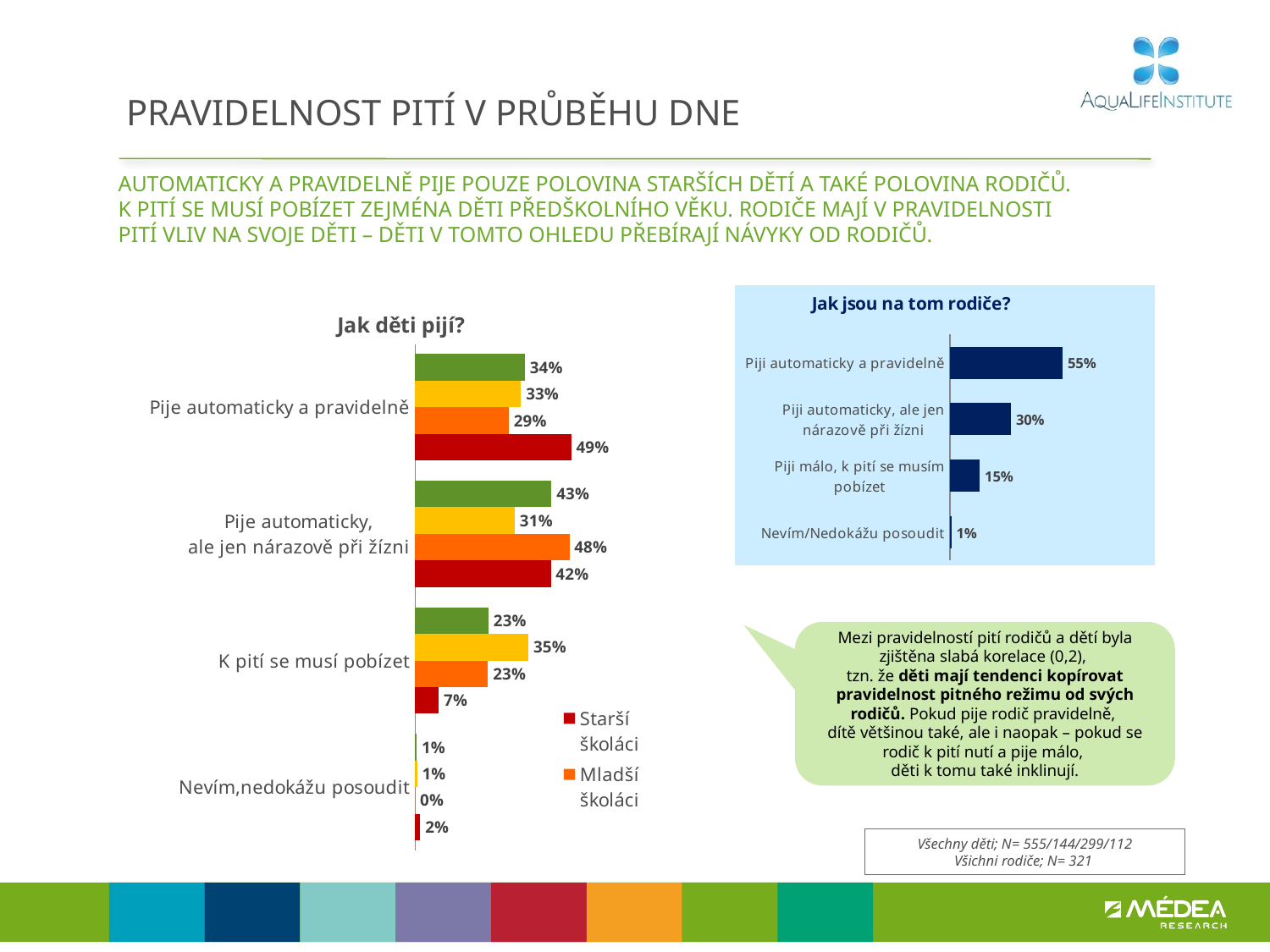
In the chart 'Jak jsou na tom rodiče?', what percentage of parents answered 'Piji automaticky a pravidelně'? 55% In the chart 'Jak děti pijí?', what is the difference between 'Starší školáci' and 'Mladší školáci' in the category 'K pití se musí pobízet'? 16 percentage points In the chart 'Jak děti pijí?', what is the value for 'Mladší školáci' in the category 'K pití se musí pobízet'? 23% In the chart 'Jak jsou na tom rodiče?', how many categories are shown? 4 What type of chart is 'Jak jsou na tom rodiče?'? Bar chart In the chart 'Jak děti pijí?', which colour represents 'Starší školáci'? Red In the chart 'Jak jsou na tom rodiče?', what is the difference between 'Piji automaticky a pravidelně' and 'Piji automaticky, ale jen nárazově při žízni'? 25 percentage points In the chart 'Jak jsou na tom rodiče?', which category has the lowest value? Nevím/Nedokážu posoudit In the chart 'Jak děti pijí?', how many categories are shown on the axis? 4 In the chart 'Jak děti pijí?', which is larger for 'Pije automaticky, ale jen nárazově při žízni': 'Starší školáci' or 'Mladší školáci'? Mladší školáci In the chart 'Jak jsou na tom rodiče?', what is the value for 'Piji málo, k pití se musím pobízet'? 15% In the chart 'Jak děti pijí?', what is the value for 'Starší školáci' in the category 'Pije automaticky a pravidelně'? 49%